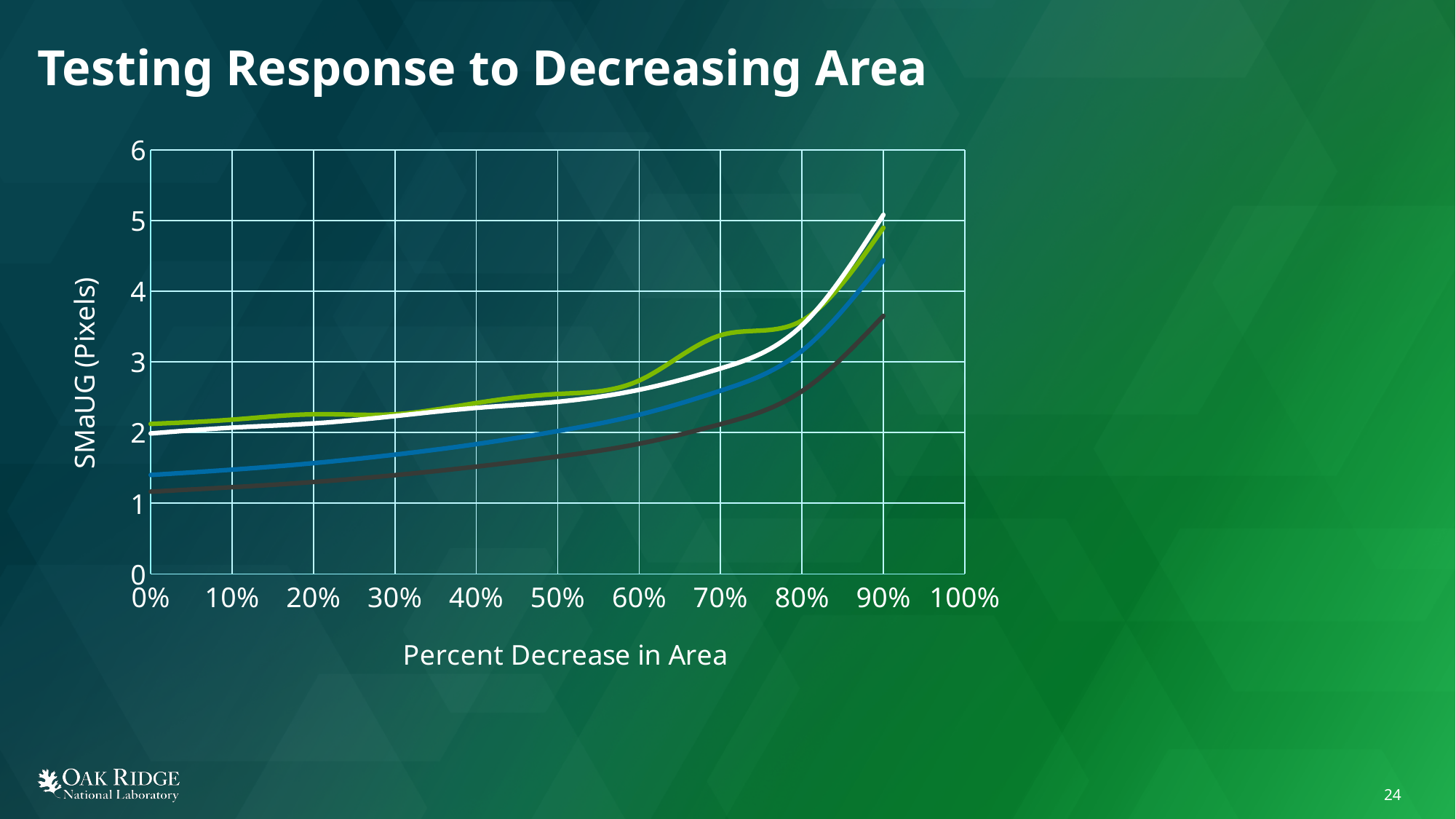
How many lines are plotted on the chart? 4 Is the value of the blue line at 90% greater or less than 4? greater At 0%, which is larger: the blue line or the dark brown line? the blue line What kind of chart is shown on the slide? line chart Is the value of the blue line at 0% greater or less than 2? less Is the value of the dark brown line at 50% greater or less than 2? less What is the label of the x axis? Percent Decrease in Area What is the label of the y axis? SMaUG (Pixels) Which line has the lowest value at 90%? the dark brown line Do the plotted lines rise or fall as the percent decrease in area increases? rise